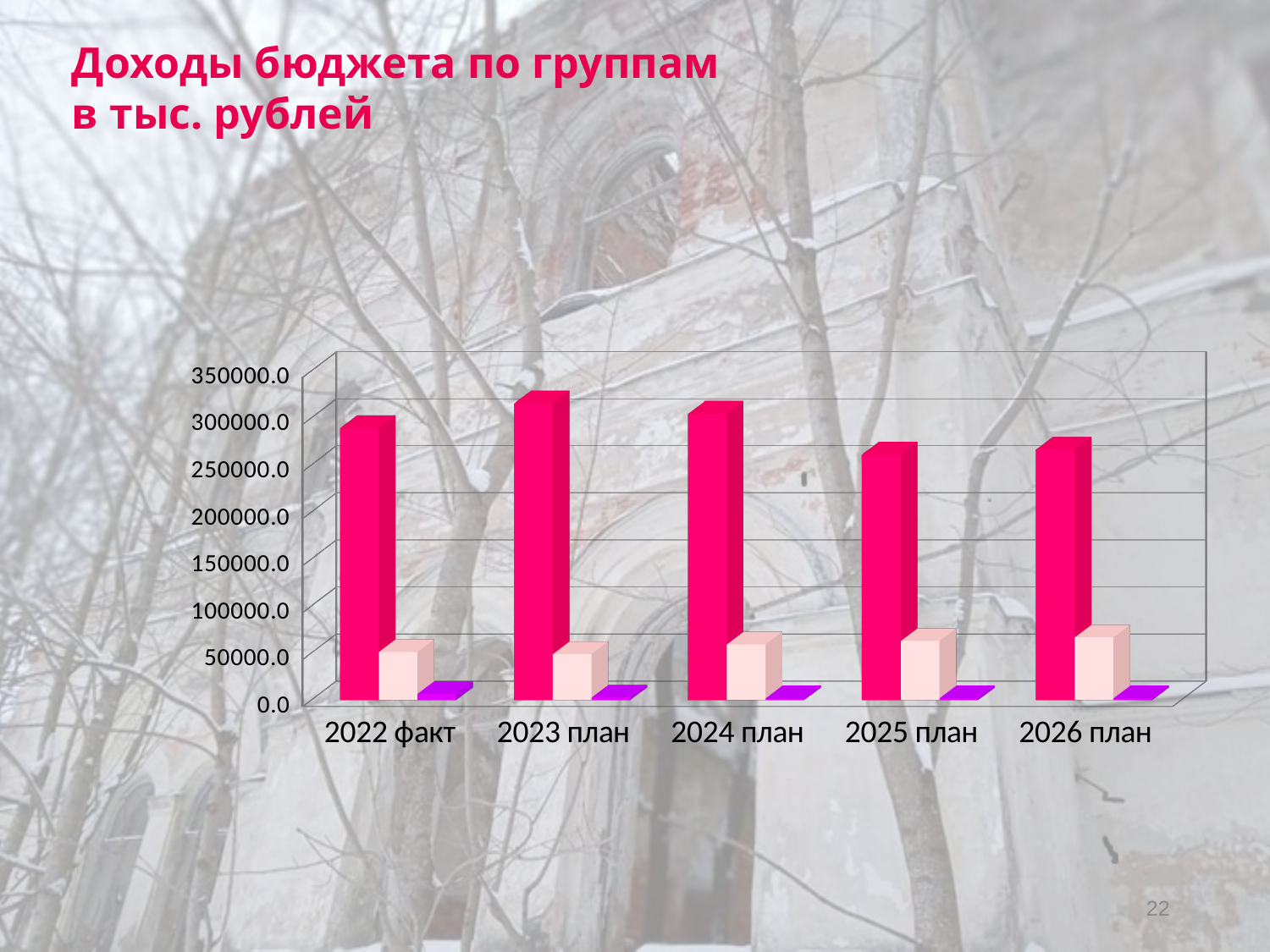
What is the title of the chart on the slide? Доходы бюджета по группам в тыс. рублей How many bars are shown for each category on the x axis? 3 Which has the larger magenta bar: 2022 факт or 2025 план? 2022 факт Is the value of the tallest (magenta) bar for 2026 план greater or less than 350000.0? less Which has the larger magenta bar: 2023 план or 2026 план? 2023 план Is the value of the tallest (magenta) bar for 2022 факт greater or less than 250000.0? greater Is the value of the tallest (magenta) bar for 2023 план greater or less than 300000.0? greater What kind of chart is shown on the slide? bar chart How many categories are shown on the x axis of the chart? 5